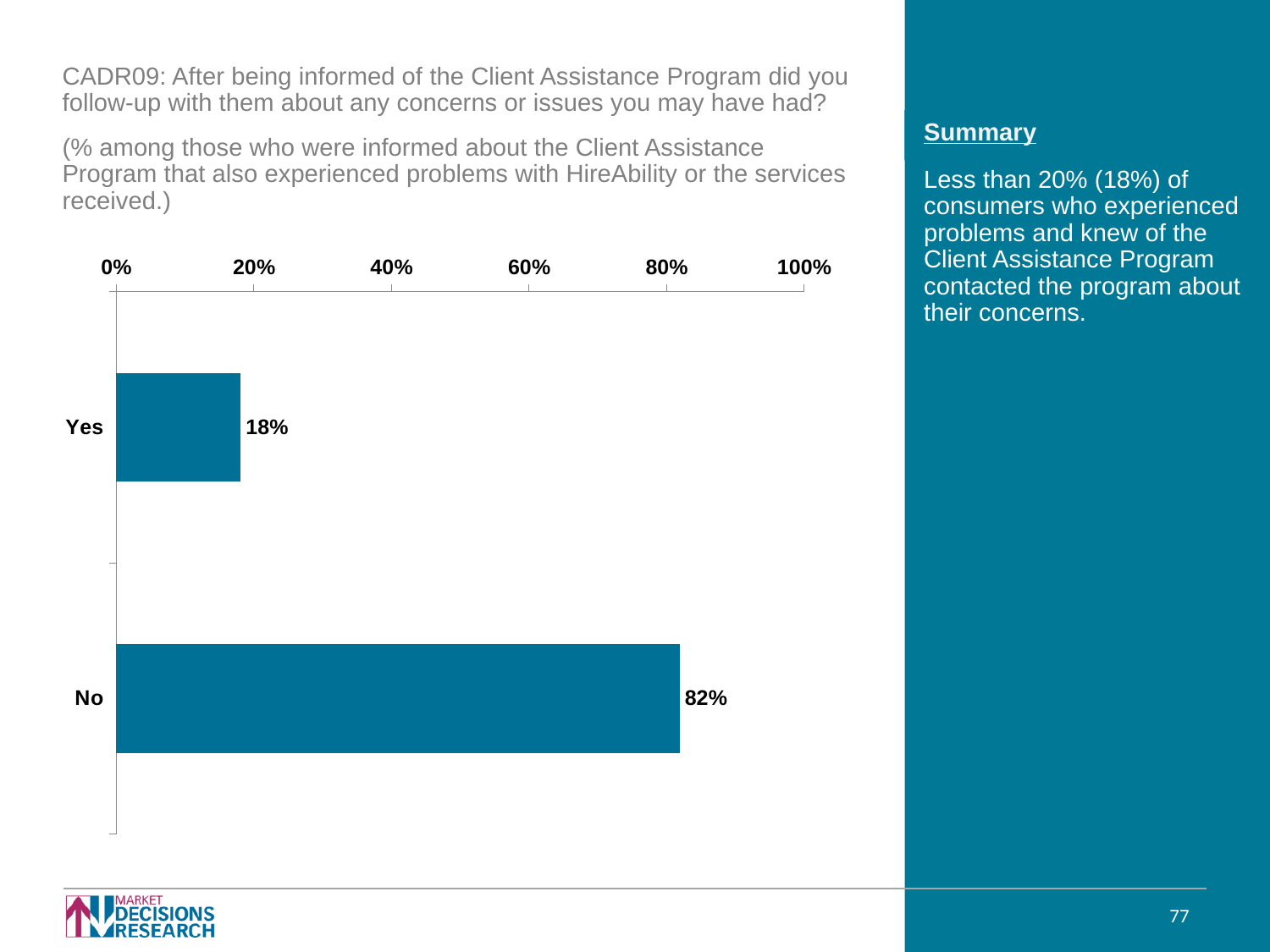
Which is larger, the value for Yes or the value for No? No Which response category has the lowest value? Yes What is the difference between the No and Yes percentages? 64% Is the value for Yes greater or less than 20%? less Is the value for No greater or less than 80%? greater What percentage of respondents answered No? 82% Which response category has the highest value? No What percentage of respondents answered Yes? 18% What is the total of the Yes and No percentages? 100% What kind of chart is shown on the slide? bar chart What is the maximum value shown on the percentage axis? 100% How many response categories are shown in the chart? 2